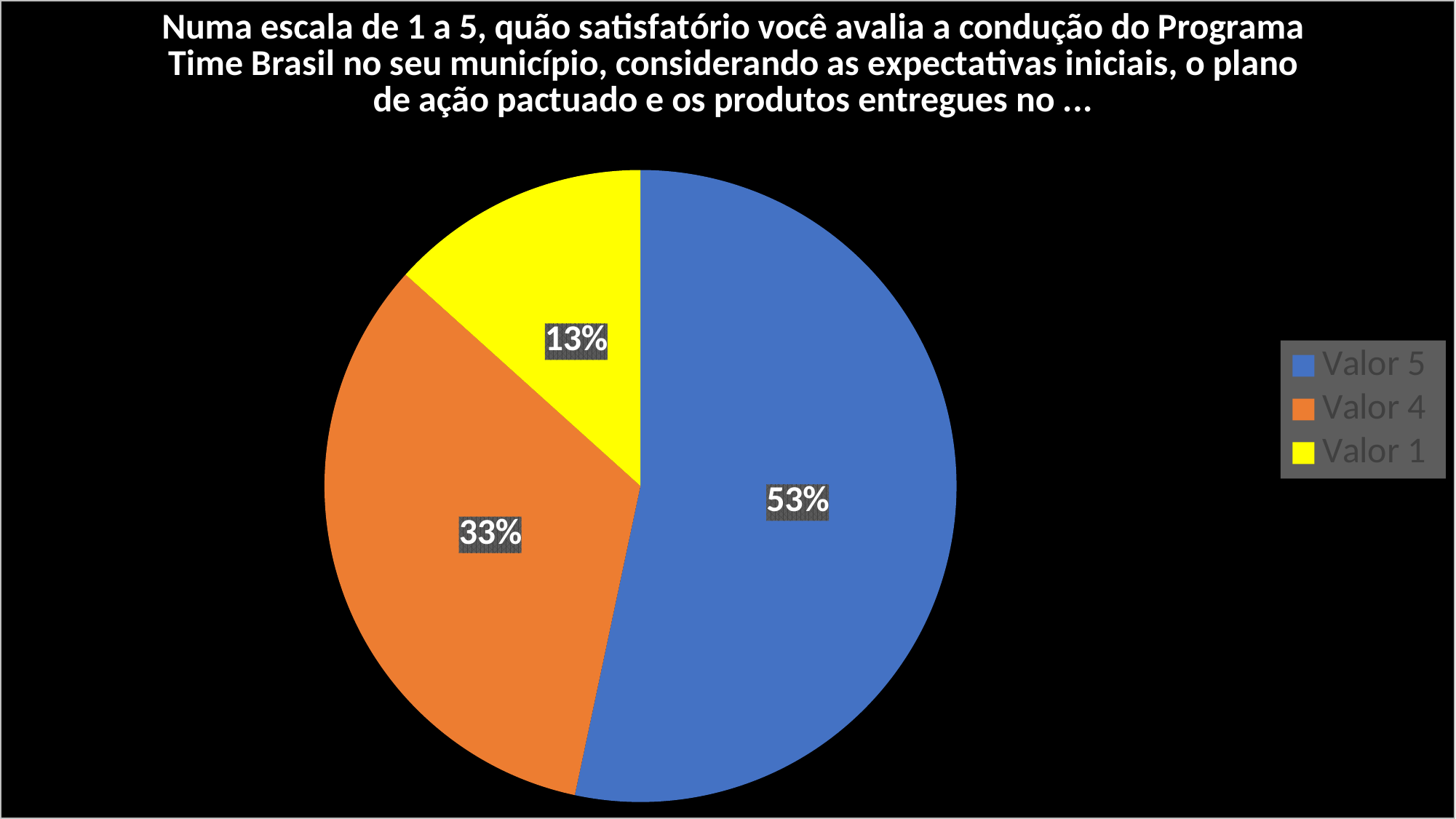
Which category has the largest slice of the pie? Valor 5 What is the difference in percentage points between Valor 5 and Valor 4? 20 What is the difference in percentage points between Valor 4 and Valor 1? 20 Which category has the smallest slice of the pie? Valor 1 What kind of chart is shown on the slide? pie chart Which is larger, the slice for Valor 4 or the slice for Valor 1? Valor 4 How many entries does the legend list? 3 What share of the pie does Valor 5 represent? 53% What colour is the slice for Valor 1? yellow What share of the pie does Valor 1 represent? 13% How many slices does the pie chart have? 3 What share of the pie does Valor 4 represent? 33%